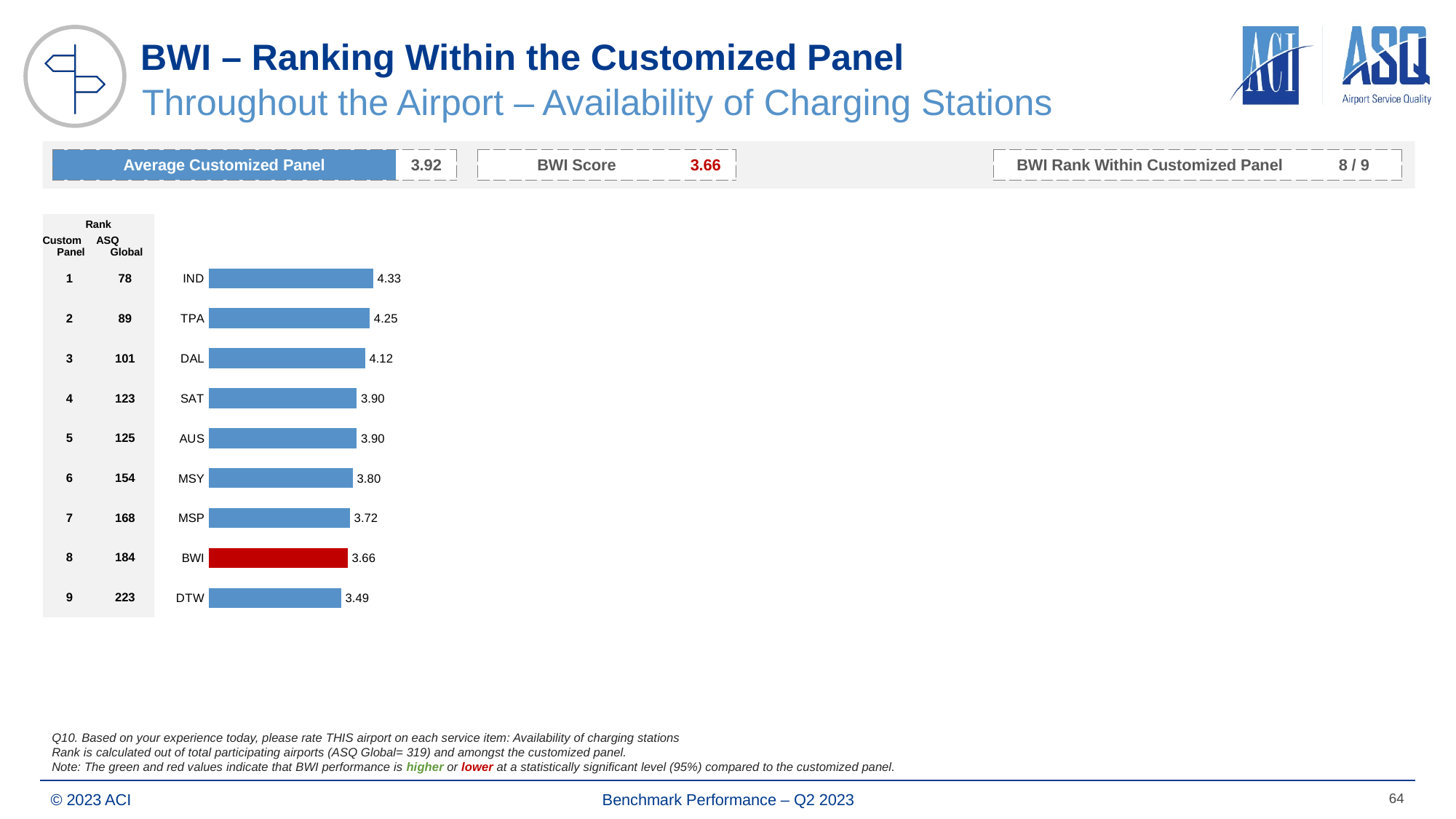
What is the difference between the values for IND and BWI? 0.67 What is the value for BWI? 3.66 Which airport has the lowest value? DTW What kind of chart is shown on the slide? bar chart What is the value for SAT? 3.90 Which airport has the highest value? IND What is the value for DTW? 3.49 How many airports are shown in the chart? 9 What is the difference between the values for TPA and DAL? 0.13 Which is larger, the value for MSY or the value for MSP? MSY Which bar is coloured red? BWI What is the value for IND? 4.33